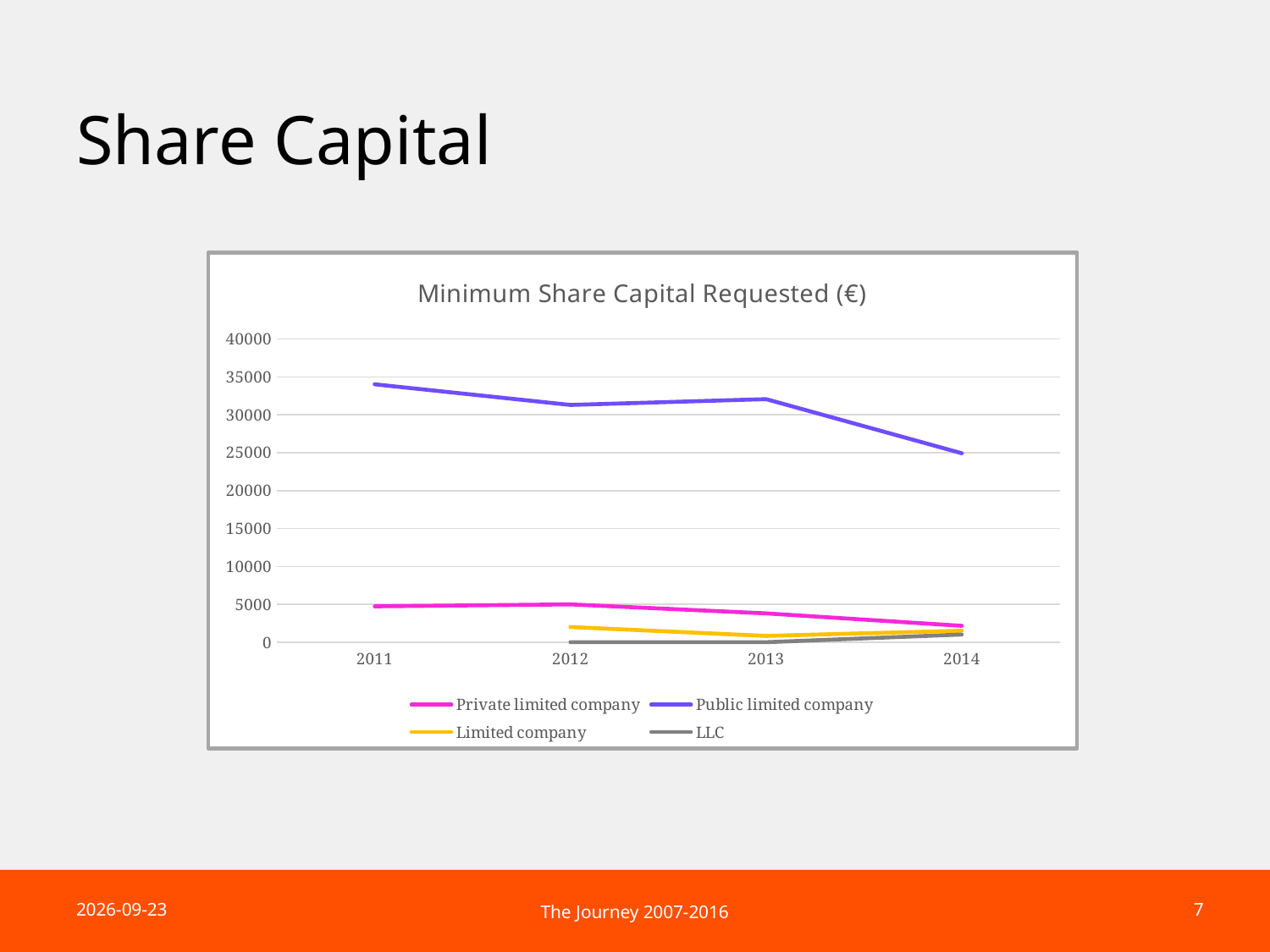
Is the value for Private limited company in 2011 greater or less than 10000? less Which series is drawn in yellow? Limited company How many years are shown on the x axis? 4 Which is larger in 2013, the value for Public limited company or the value for Private limited company? Public limited company What kind of chart is shown on the slide? line chart What is the title of the chart? Minimum Share Capital Requested (€) Which series has the highest values across all years? Public limited company Is the value for Public limited company in 2014 greater or less than 30000? less Does the Public limited company line rise or fall from 2013 to 2014? fall Is the value for Public limited company in 2011 greater or less than 30000? greater How many series does the legend list? 4 Which is larger in 2012, the value for Private limited company or the value for LLC? Private limited company